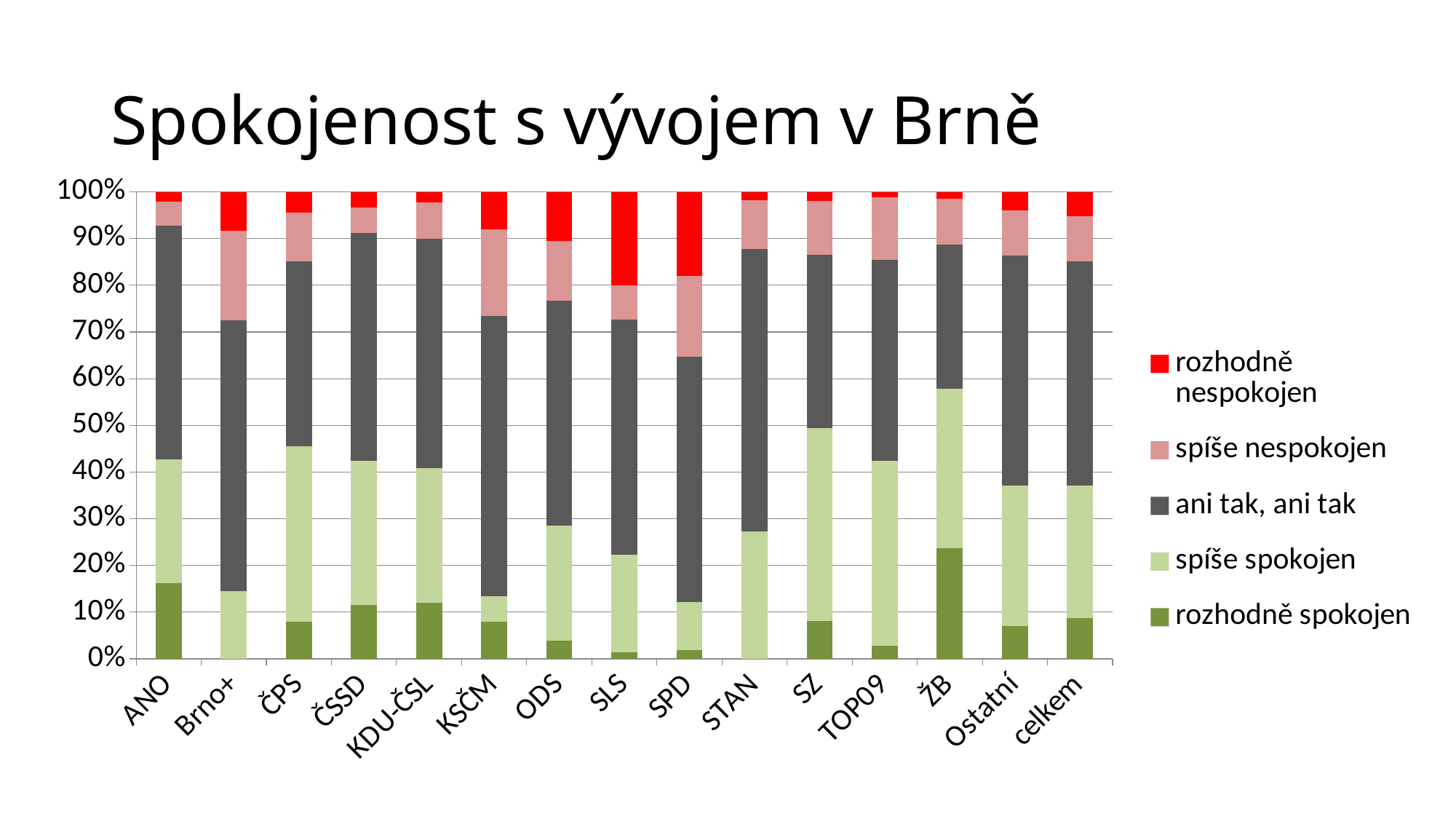
Which has a larger 'rozhodně spokojen' share, ŽB or ANO? ŽB Which has a larger 'rozhodně spokojen' share, ANO or ČPS? ANO Which colour represents 'rozhodně nespokojen' in the legend? Red How many categories are shown on the x axis? 15 Which category has the largest 'rozhodně spokojen' share? ŽB What is the title of the chart? Spokojenost s vývojem v Brně How many series does the legend list? 5 What kind of chart is shown on the slide? Stacked bar chart What does each stacked bar total? 100% Is the 'rozhodně spokojen' value for ŽB greater or less than 20%? greater Is the 'rozhodně spokojen' value for ANO greater or less than 10%? greater Is the 'rozhodně spokojen' value for SLS greater or less than 10%? less